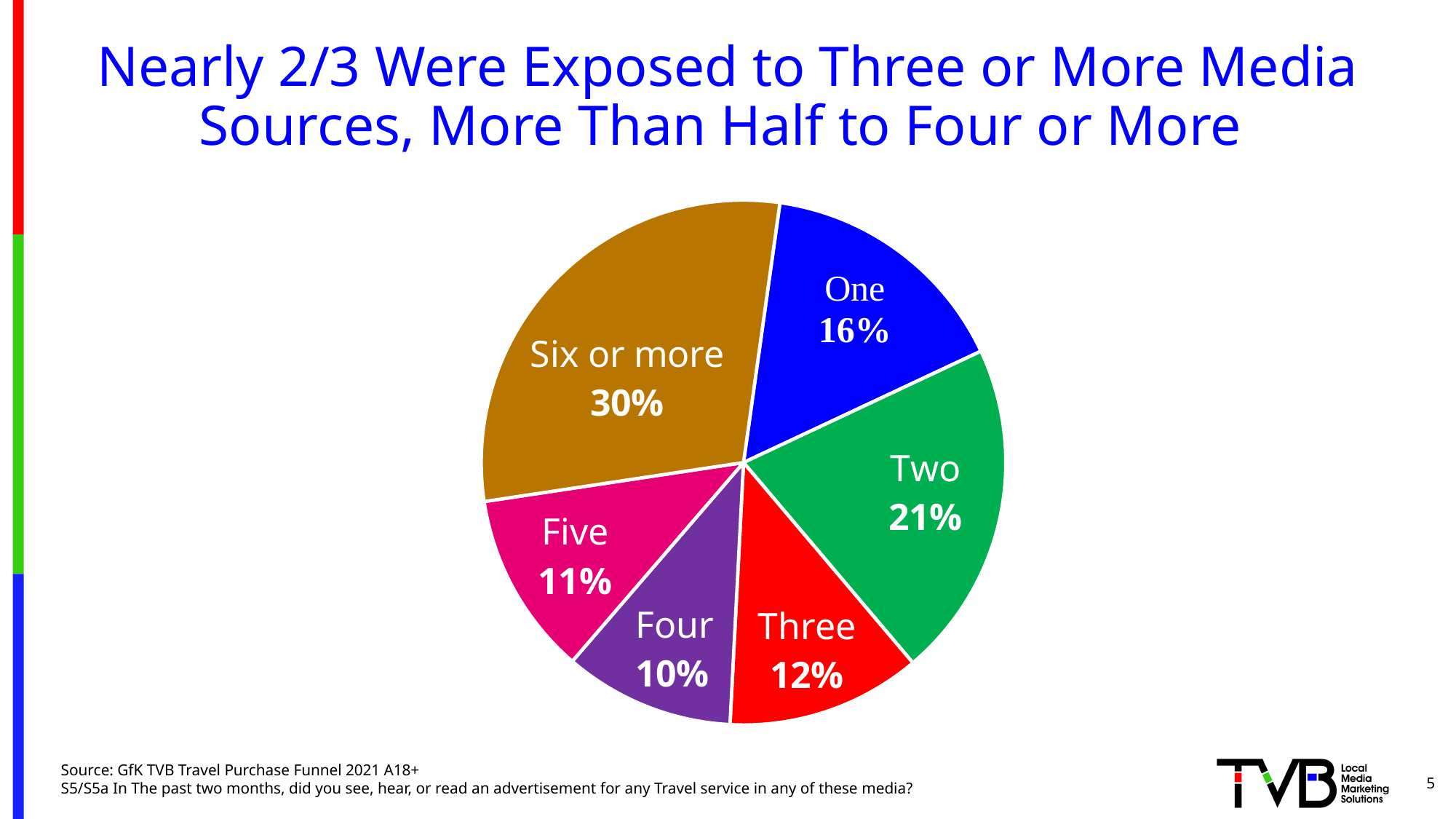
Which slice is larger, "Two" or "Three"? Two How many slices does the pie chart have? 6 What kind of chart is shown on the slide? Pie chart What colour is the "Three" slice? Red What is the combined share of the "Five" and "Six or more" slices? 41% What value is printed on the "Four" slice? 10% What is the title of the slide? Nearly 2/3 Were Exposed to Three or More Media Sources, More Than Half to Four or More Which category has the smallest slice of the pie? Four What is the difference in percentage points between the "Six or more" slice and the "One" slice? 14 Which category has the largest slice of the pie? Six or more What percentage is shown for the "Two" slice? 21% What share of the pie is labelled "Six or more"? 30%